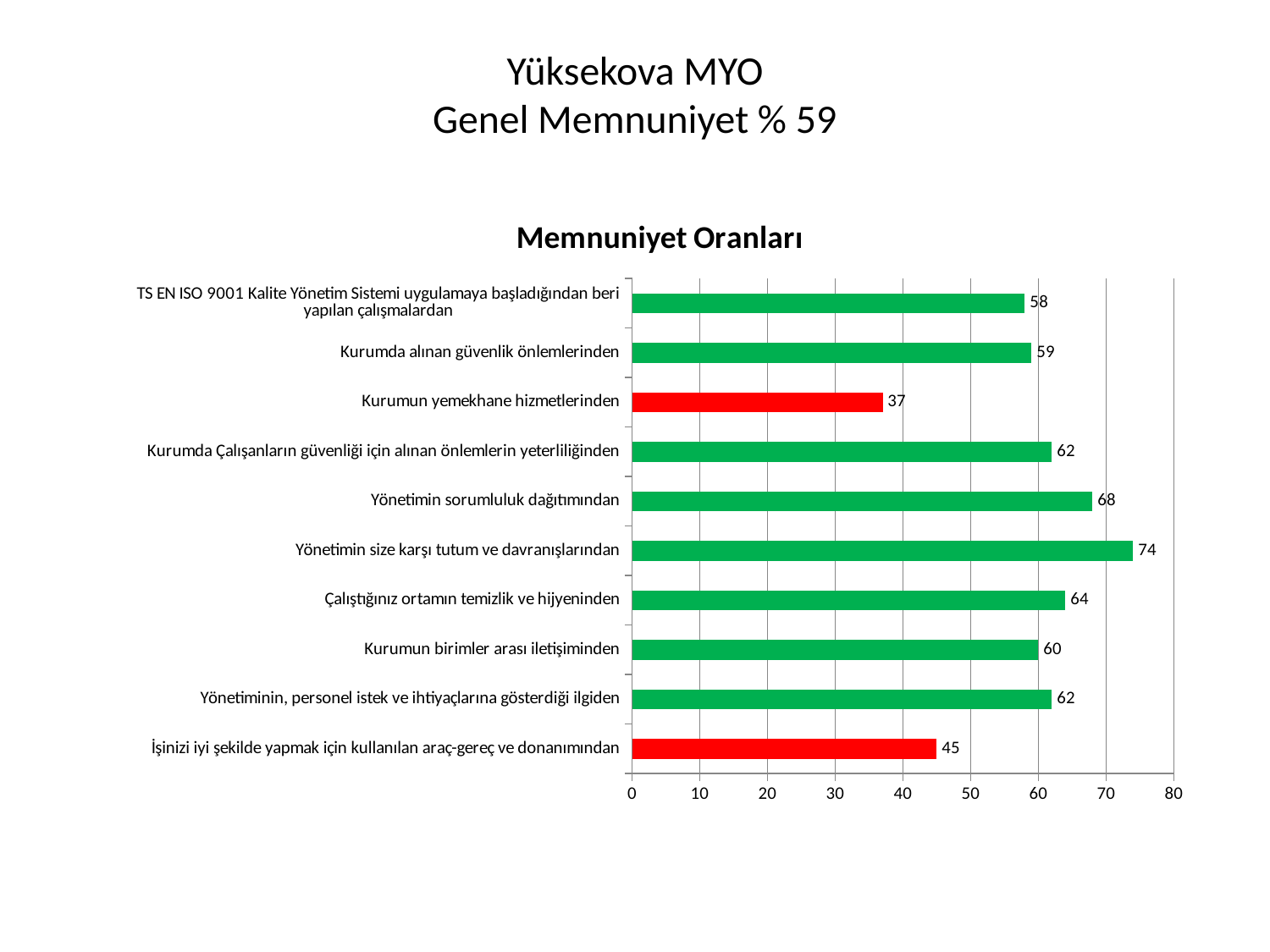
What is the difference between the values for "Yönetimin size karşı tutum ve davranışlarından" and "Kurumun yemekhane hizmetlerinden"? 37 Which is larger: the value for "Çalıştığınız ortamın temizlik ve hijyeninden" or the value for "Kurumda alınan güvenlik önlemlerinden"? Çalıştığınız ortamın temizlik ve hijyeninden What kind of chart is shown on the slide? bar chart How many bars are coloured red? 2 What is the value for "Kurumun birimler arası iletişiminden"? 60 Is the value for "İşinizi iyi şekilde yapmak için kullanılan araç-gereç ve donanımından" greater or less than 50? less How many categories are shown in the chart? 10 What is the value for "Yönetimin sorumluluk dağıtımından"? 68 What is the title of the chart? Memnuniyet Oranları Which category has the lowest value? Kurumun yemekhane hizmetlerinden What is the value for "Kurumun yemekhane hizmetlerinden"? 37 Which category has the highest value? Yönetimin size karşı tutum ve davranışlarından